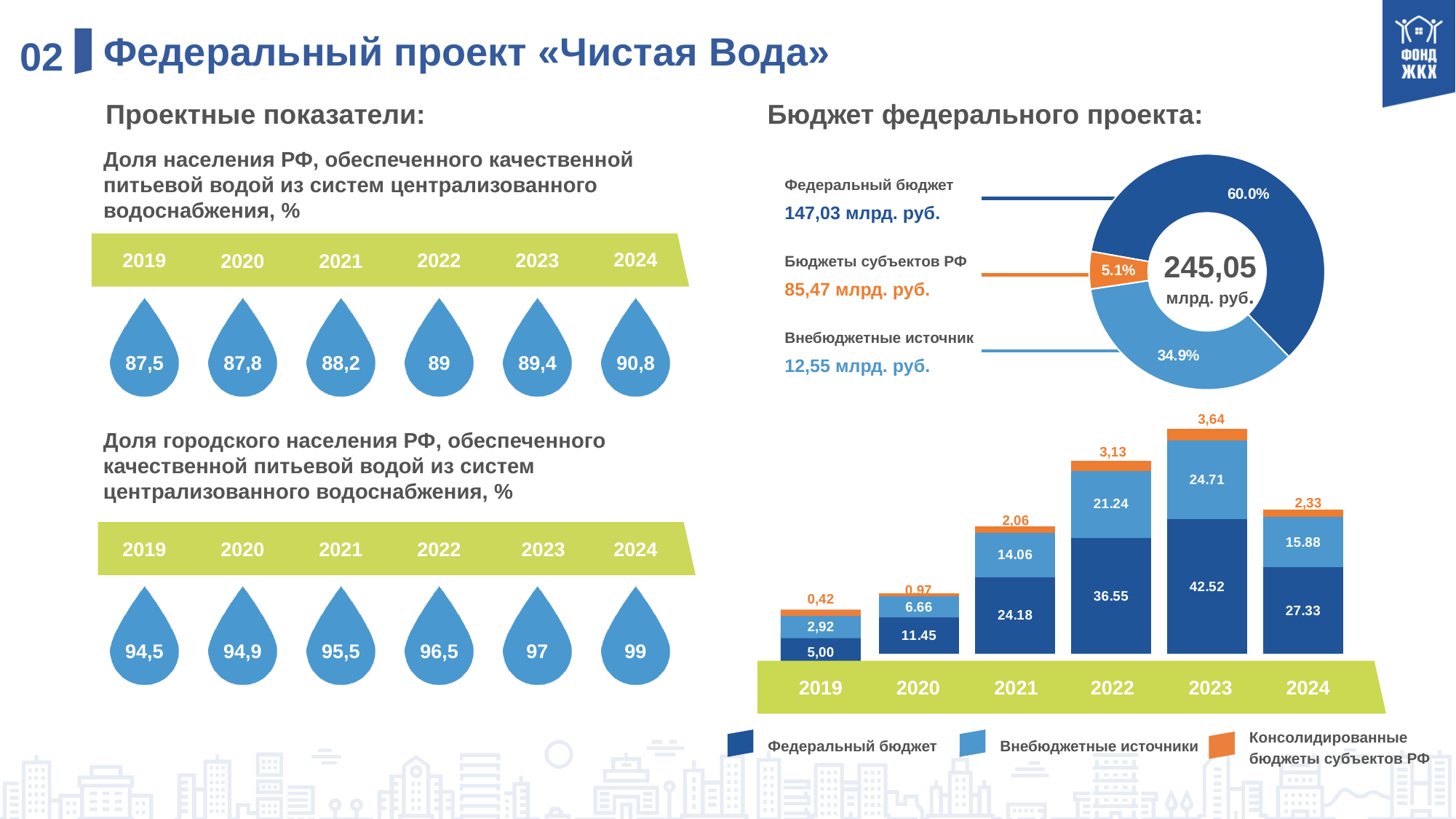
In the stacked bar chart, what is the total of the stacked bar for 2023? 70.87 In the stacked bar chart, what is the value of Внебюджетные источники for 2022? 21.24 In the donut chart, what share is labelled for the dark blue slice (Федеральный бюджет)? 60.0% In the stacked bar chart, what is the difference between the Федеральный бюджет values for 2023 and 2022? 5.97 In the stacked bar chart, how many series does the legend list? 3 What total value is printed in the centre of the donut chart? 245,05 млрд. руб. In the stacked bar chart, which year has the highest value for Консолидированные бюджеты субъектов РФ? 2023 In the stacked bar chart, what is the value of Федеральный бюджет for 2023? 42.52 In the donut chart, what share is labelled for the light blue slice? 34.9% What kind of chart is the chart at the bottom right of the slide showing values by year from 2019 to 2024? stacked bar chart In the donut chart, what share is labelled for the orange slice? 5.1% In the stacked bar chart, how many years are shown on the x axis? 6